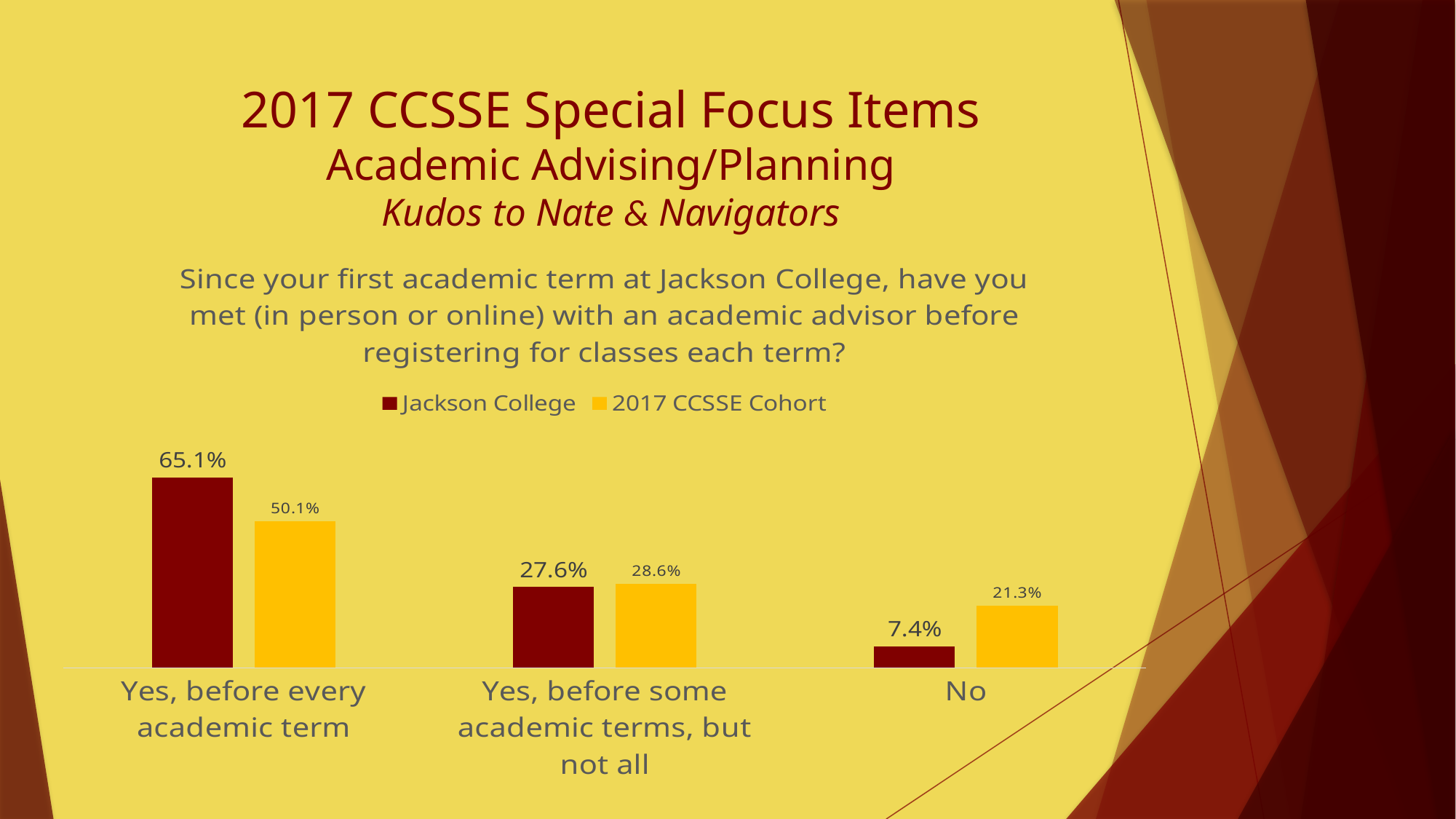
What is the 2017 CCSSE Cohort value for "No"? 21.3% What kind of chart is shown on the slide? Bar chart What is the 2017 CCSSE Cohort value for "Yes, before some academic terms, but not all"? 28.6% How many series does the chart legend list? 2 What is the difference between the 2017 CCSSE Cohort and Jackson College values for "No"? 13.9% Which category has the lowest 2017 CCSSE Cohort value? No What is the difference between the Jackson College and 2017 CCSSE Cohort values for "Yes, before every academic term"? 15.0% How many categories are shown on the x axis of the chart? 3 What is the Jackson College value for "No"? 7.4% What is the Jackson College value for "Yes, before every academic term"? 65.1% For "Yes, before some academic terms, but not all", which series has the larger value, Jackson College or 2017 CCSSE Cohort? 2017 CCSSE Cohort Which category has the highest Jackson College value? Yes, before every academic term